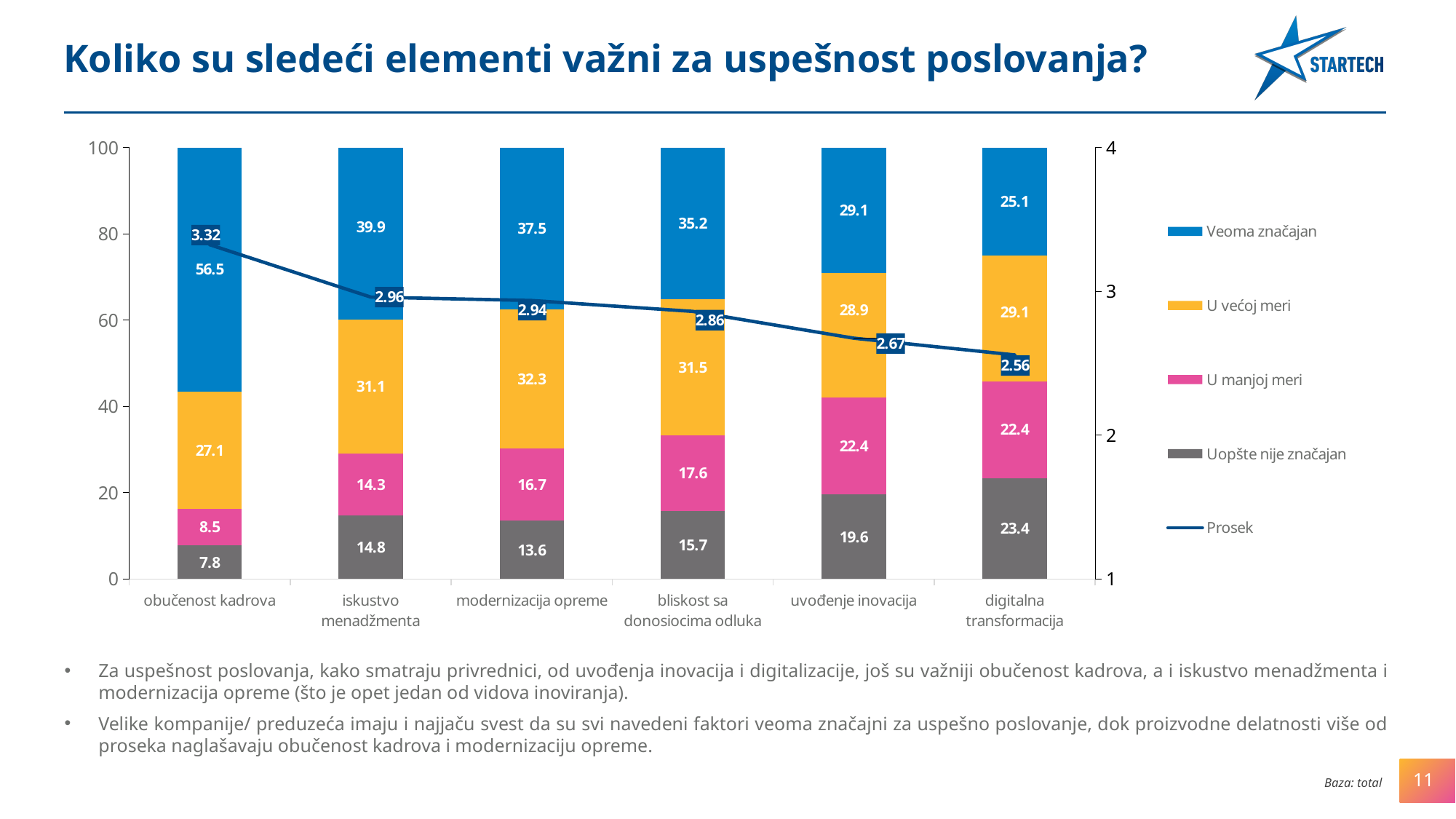
Which category has the highest Prosek value? obučenost kadrova How many series does the legend list? 5 What is the Prosek value for digitalna transformacija? 2.56 How many categories are shown on the x axis? 6 Which legend entry is shown in yellow? U većoj meri What is the difference between the 'U većoj meri' values for modernizacija opreme and obučenost kadrova? 5.2 What kind of chart is shown on the slide? Stacked bar chart with a line Which is larger: the 'U manjoj meri' value for bliskost sa donosiocima odluka or for iskustvo menadžmenta? bliskost sa donosiocima odluka What is the 'Uopšte nije značajan' value for uvođenje inovacija? 19.6 Does the Prosek line rise or fall from left to right along the x axis? fall What is the 'Veoma značajan' value for obučenost kadrova? 56.5 Which category has the lowest 'Veoma značajan' value? digitalna transformacija